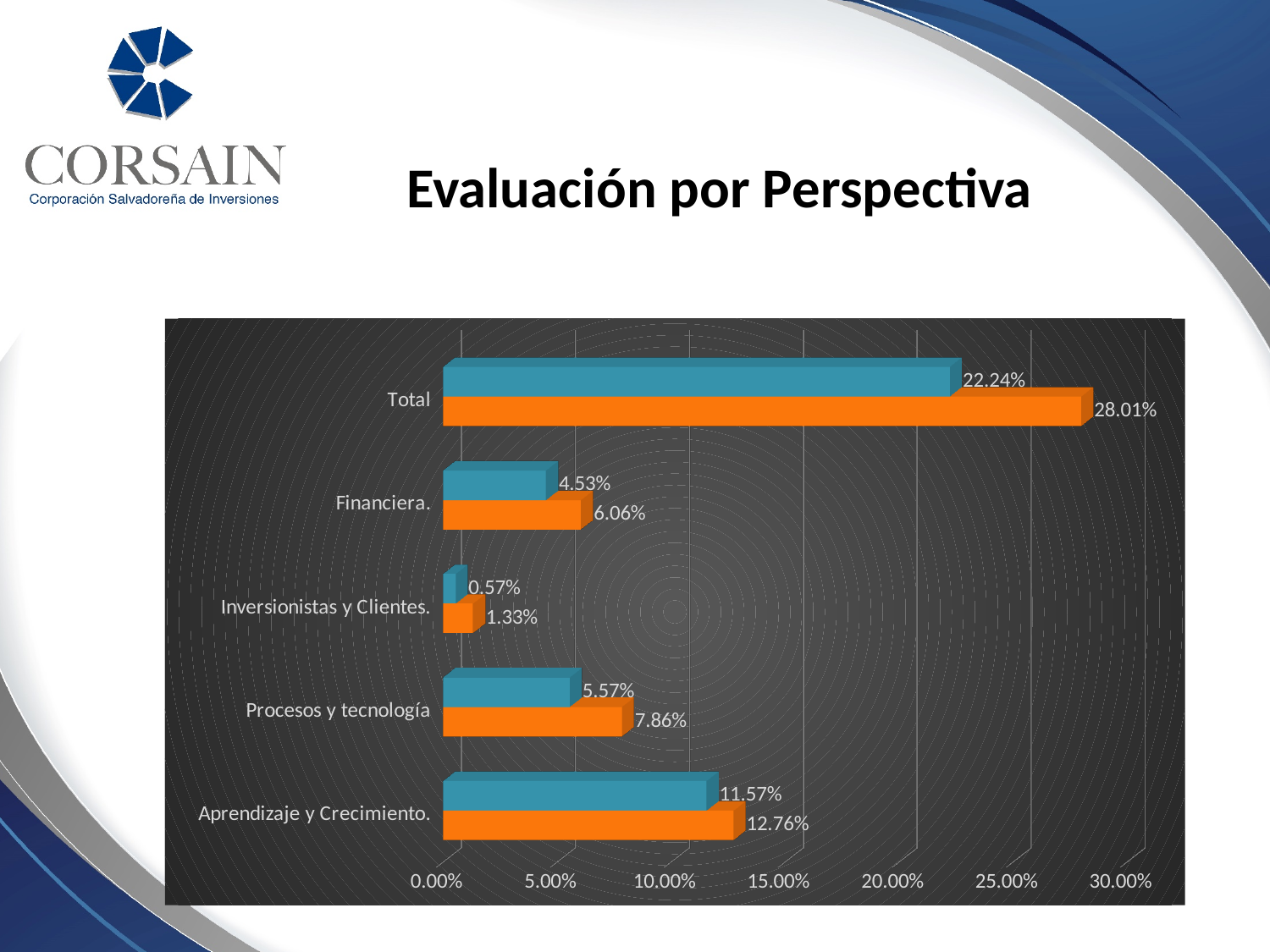
What is the difference between the orange and blue bars for Total? 5.77% What is the value of the blue bar for Aprendizaje y Crecimiento? 11.57% What is the difference between the orange bar for Financiera and the orange bar for Inversionistas y Clientes? 4.73% Excluding Total, which category has the highest value for the orange bars? Aprendizaje y Crecimiento. How many categories are shown on the vertical axis of the chart? 5 What type of chart is shown on the slide? Bar chart What is the value of the orange bar for Total? 28.01% What is the value of the orange bar for Procesos y tecnología? 7.86% Which category has the lowest value for the blue bars? Inversionistas y Clientes. Is the value of the blue bar for Total greater or less than 20.00%? greater What is the value of the blue bar for Financiera? 4.53% Which is larger, the blue bar for Procesos y tecnología or the blue bar for Financiera? Procesos y tecnología